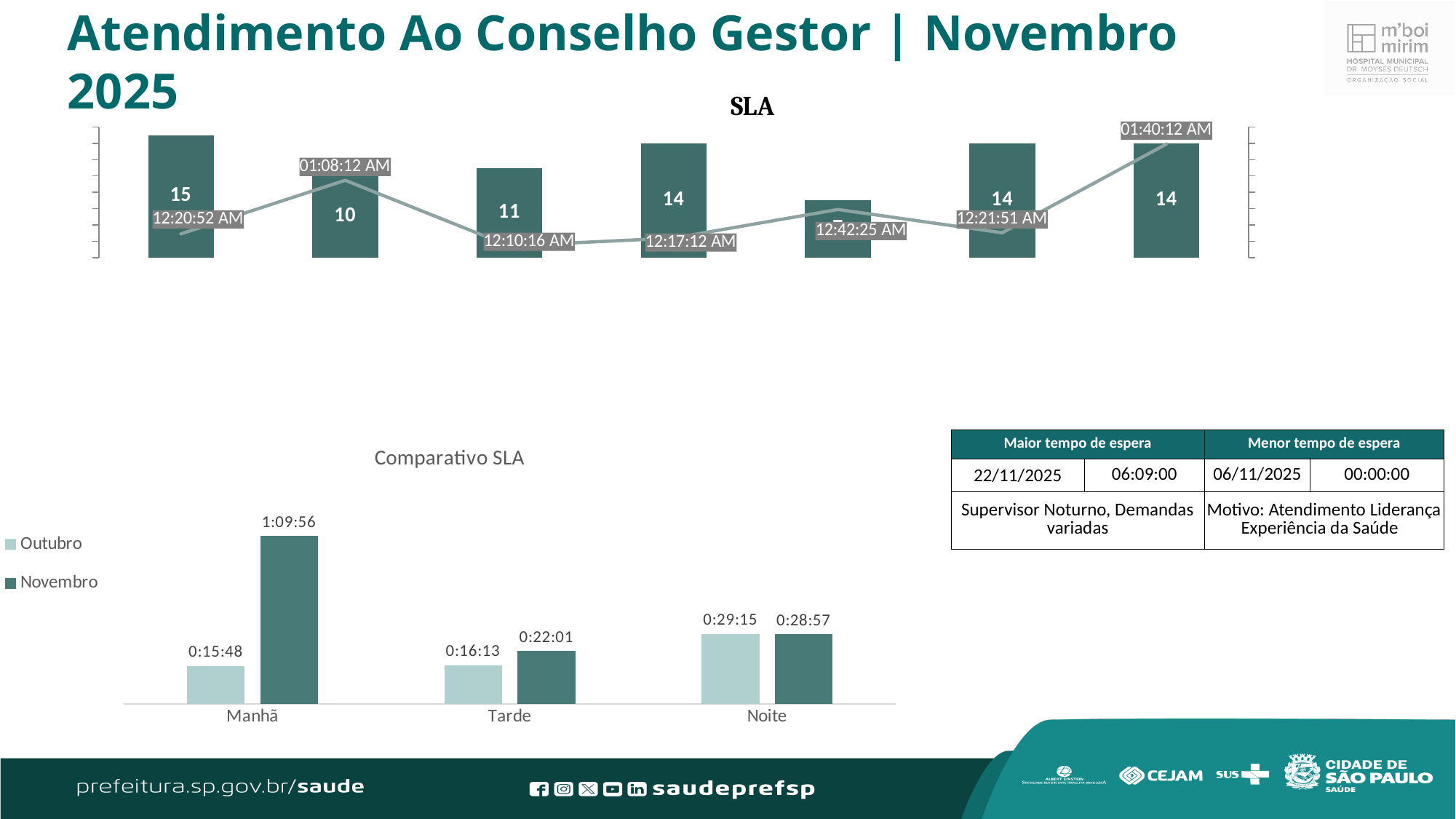
How many bars are plotted in the SLA chart at the top of the slide? 7 In the Comparativo SLA chart, for Noite, which series has the larger value, Outubro or Novembro? Outubro In the Comparativo SLA chart, which period has the lowest Outubro value? Manhã What kind of chart is the Comparativo SLA chart? Bar chart How many series does the legend of the Comparativo SLA chart list? 2 In the Comparativo SLA chart, what is the Outubro value for Tarde? 0:16:13 In the Comparativo SLA chart, which period has the highest Novembro value? Manhã What are the legend entries of the Comparativo SLA chart? Outubro, Novembro In the Comparativo SLA chart, what is the Novembro value for Manhã? 1:09:56 In the Comparativo SLA chart, what is the Outubro value for Noite? 0:29:15 In the Comparativo SLA chart, what is the Novembro value for Tarde? 0:22:01 How many periods (categories) are shown on the x axis of the Comparativo SLA chart? 3